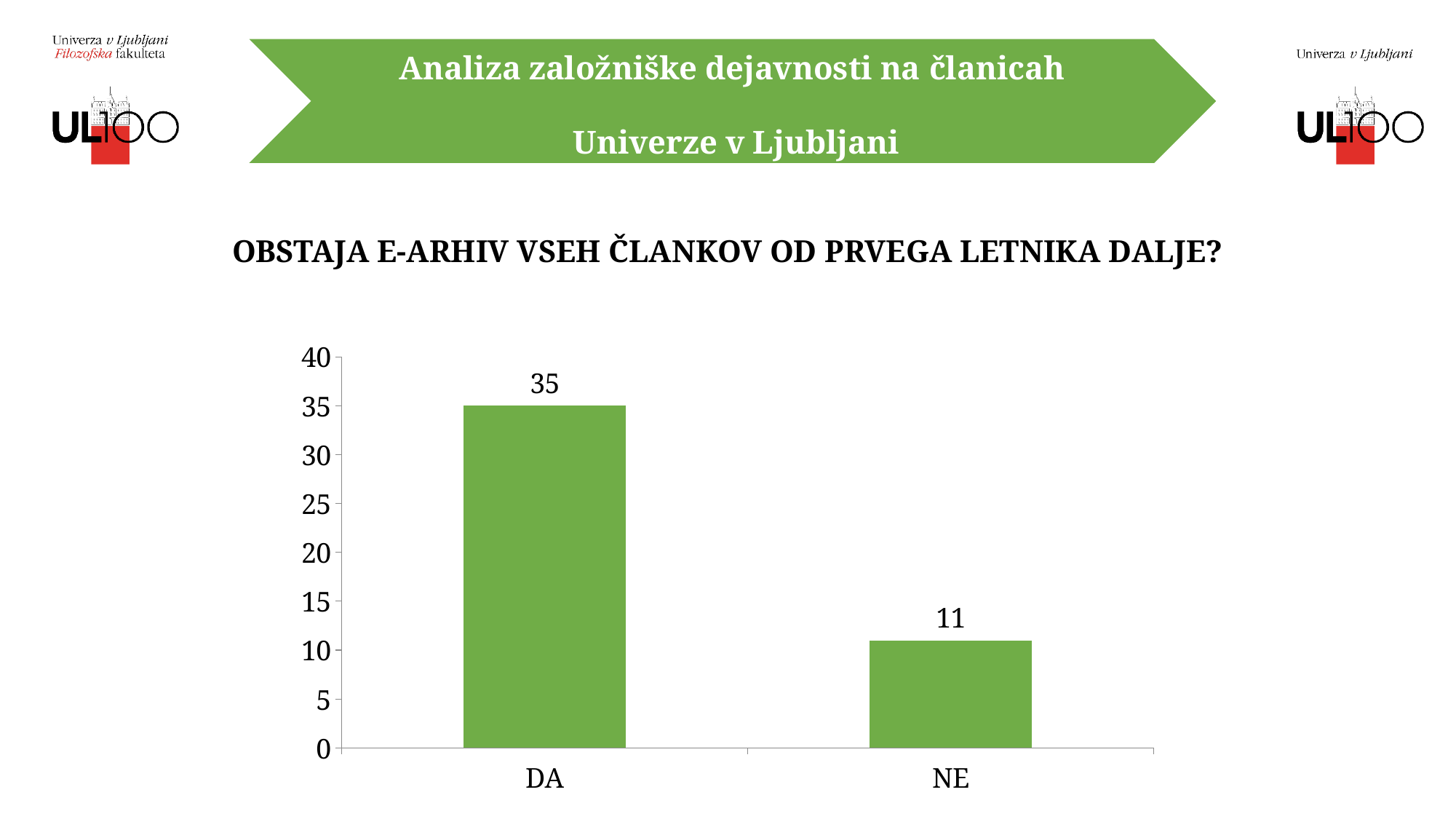
Which is larger, the value for DA or the value for NE? DA Which category has the lowest value? NE Is the value for DA greater or less than 30? greater What is the value for DA? 35 What kind of chart is shown on the slide? bar chart What is the difference between the values for DA and NE? 24 How many categories are shown on the x axis? 2 What is the total of the values for DA and NE? 46 Is the value for NE greater or less than 15? less What is the value for NE? 11 Which category has the highest value? DA What is the highest value shown on the y axis? 40